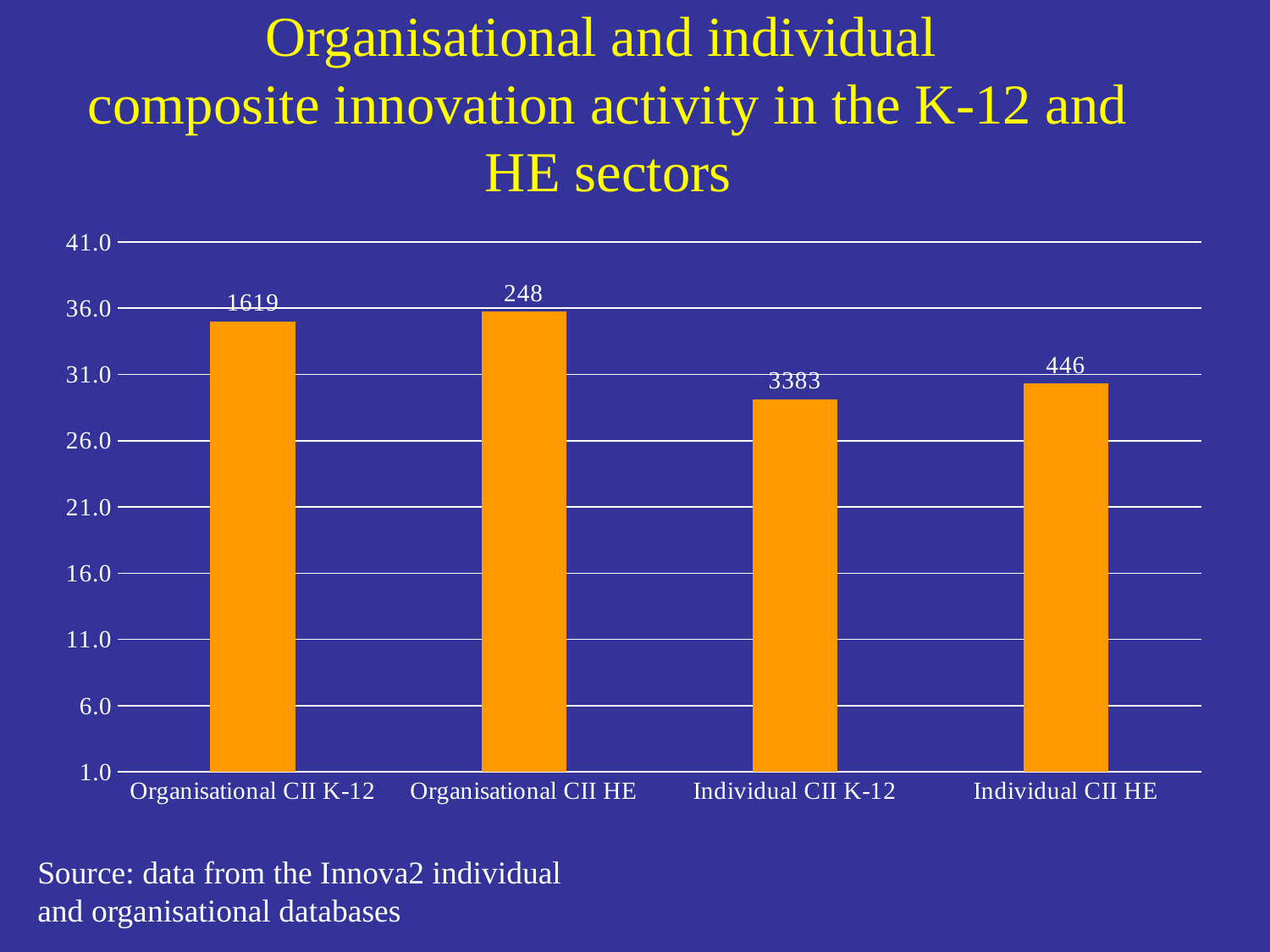
What kind of chart is shown on the slide? bar chart What number is printed above the bar for Individual CII K-12? 3383 Which is larger, the value for Organisational CII HE or the value for Individual CII HE? Organisational CII HE Is the value for Individual CII HE greater or less than 26.0? greater How many categories are plotted on the chart? 4 Is the value for Individual CII K-12 greater or less than 26.0? greater What is the highest value shown on the vertical axis? 41.0 Is the value for Organisational CII K-12 greater or less than 36.0? less Which is larger, the value for Organisational CII K-12 or the value for Individual CII K-12? Organisational CII K-12